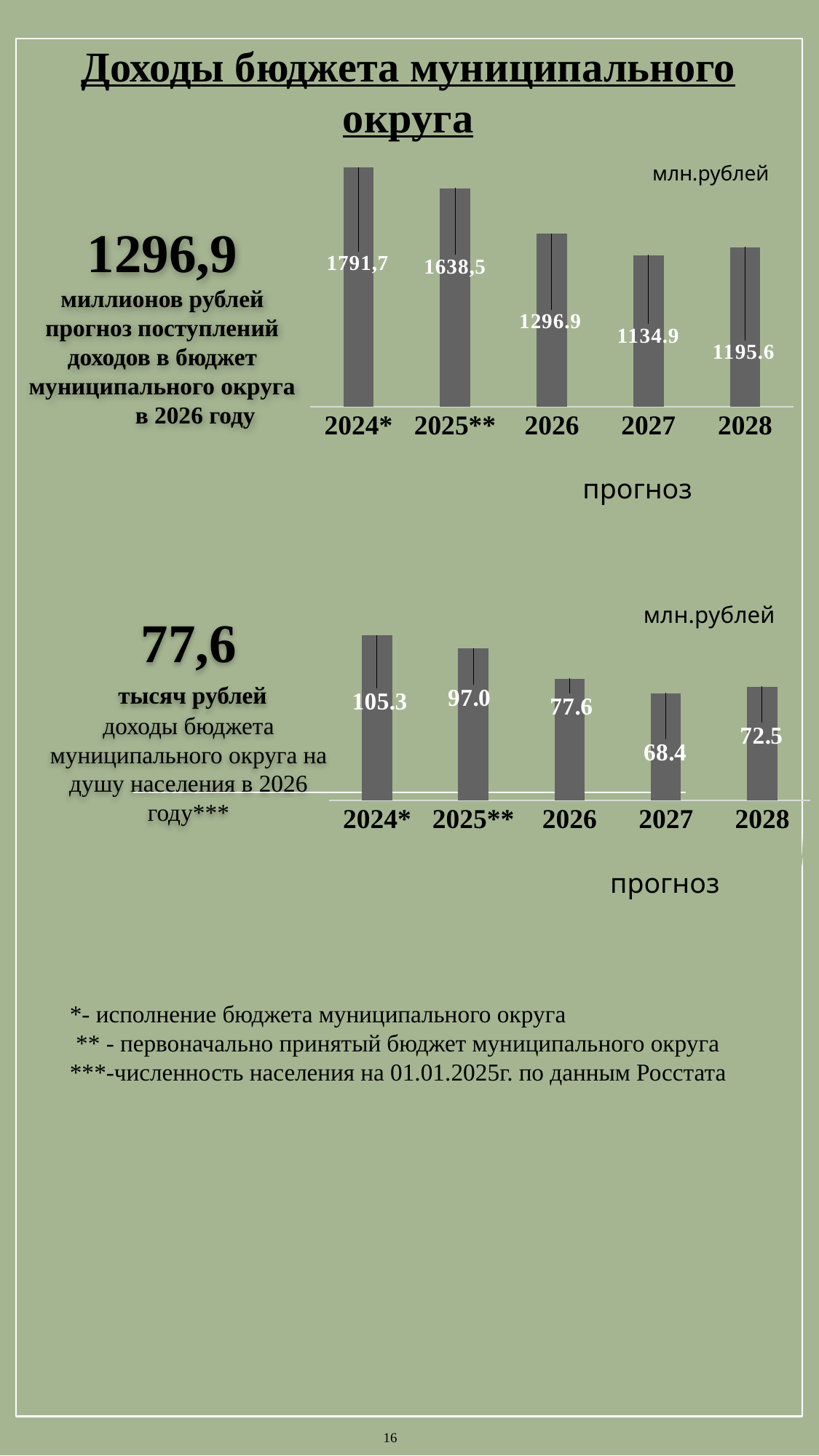
In the top chart, how many bars are plotted? 5 In the bottom chart, what is the value for 2025**? 97.0 What kind of chart is the top chart? bar chart In the top chart, which year has the highest value? 2024* In the bottom chart, what is the difference between the values for 2024* and 2025**? 8.3 In the top chart, what is the value for 2026? 1296.9 In the top chart, what is the value for 2024*? 1791,7 In the bottom chart, do the values rise or fall from 2024* to 2027? fall In the bottom chart, which is larger, the value for 2026 or the value for 2028? 2026 In the top chart, what is the difference between the values for 2028 and 2027? 60.7 In the bottom chart, what is the value for 2027? 68.4 In the top chart, which year has the lowest value? 2027